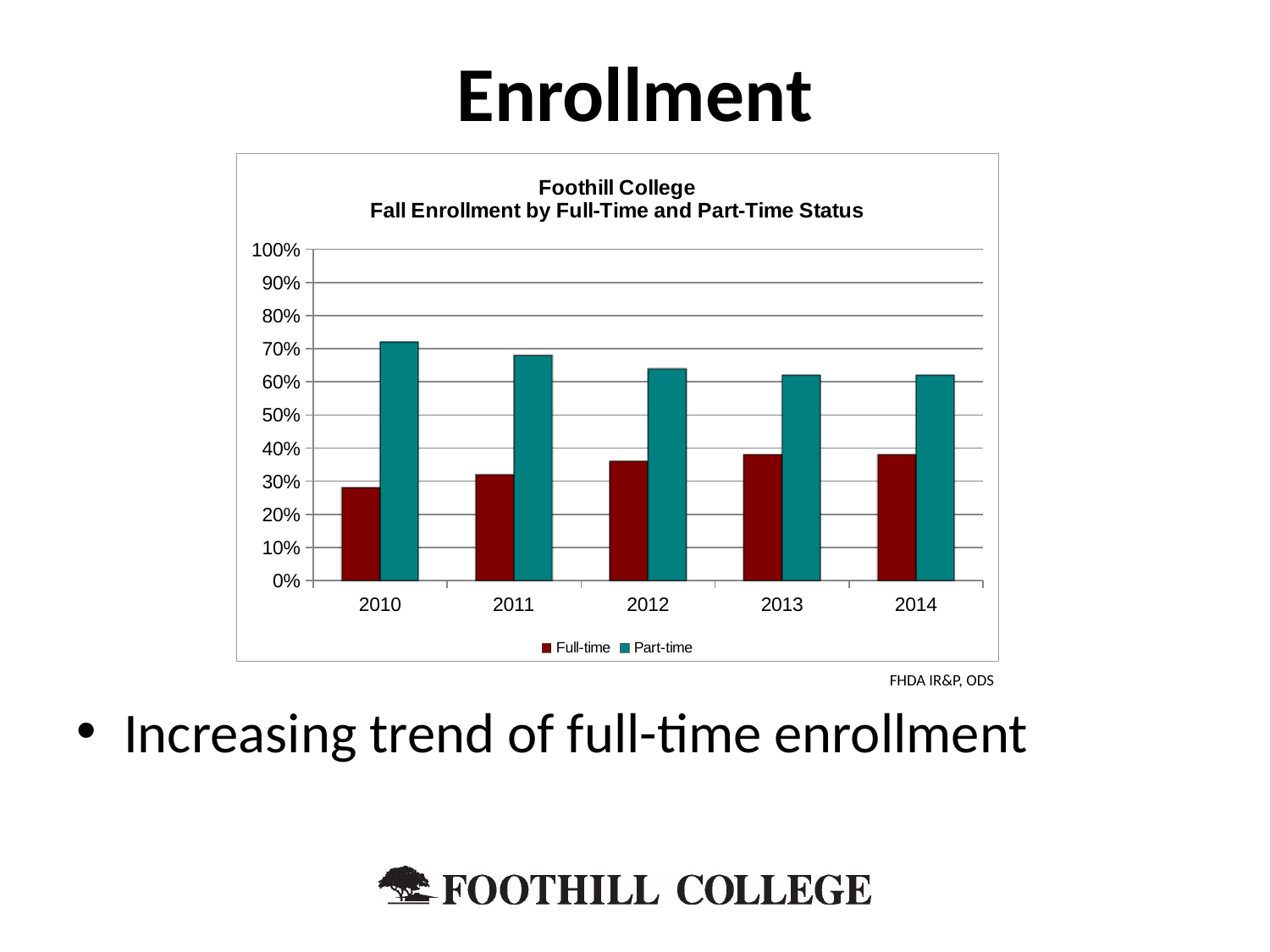
Is the Part-time value for 2012 greater or less than 60%? greater How many years are shown on the x axis? 5 Which is larger in 2013, the Full-time value or the Part-time value? Part-time Which year has the lowest Full-time value? 2010 What kind of chart is shown on the slide? Bar chart Is the Full-time value for 2014 greater or less than 40%? less Do the Full-time values rise or fall from 2010 to 2014? Rise What is the title of the chart? Foothill College Fall Enrollment by Full-Time and Part-Time Status Is the Part-time value for 2010 greater or less than 70%? greater Which year has the highest Part-time value? 2010 How many series does the legend list? 2